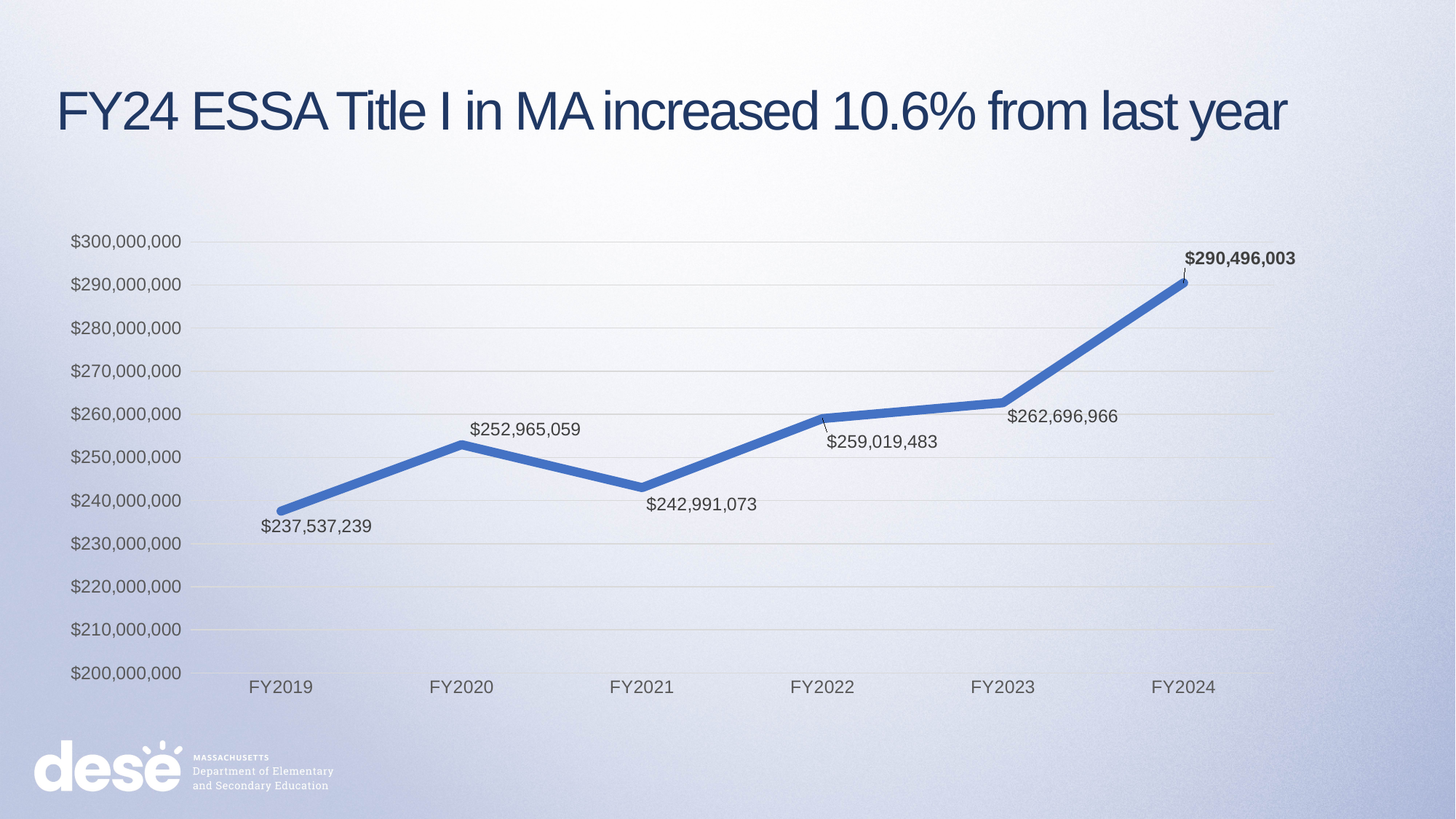
Which fiscal year has the lowest value? FY2019 What is the value for FY2024? $290,496,003 Which fiscal year has the highest value? FY2024 Which is larger, the value for FY2020 or the value for FY2021? FY2020 What is the difference between the FY2020 and FY2021 values? $9,973,986 Do the values generally rise or fall from FY2019 to FY2024? Rise What kind of chart is shown on the slide? Line chart What is the value for FY2023? $262,696,966 What is the difference between the FY2024 and FY2023 values? $27,799,037 What is the value for FY2021? $242,991,073 What is the value for FY2019? $237,537,239 How many fiscal years are plotted on the chart? 6